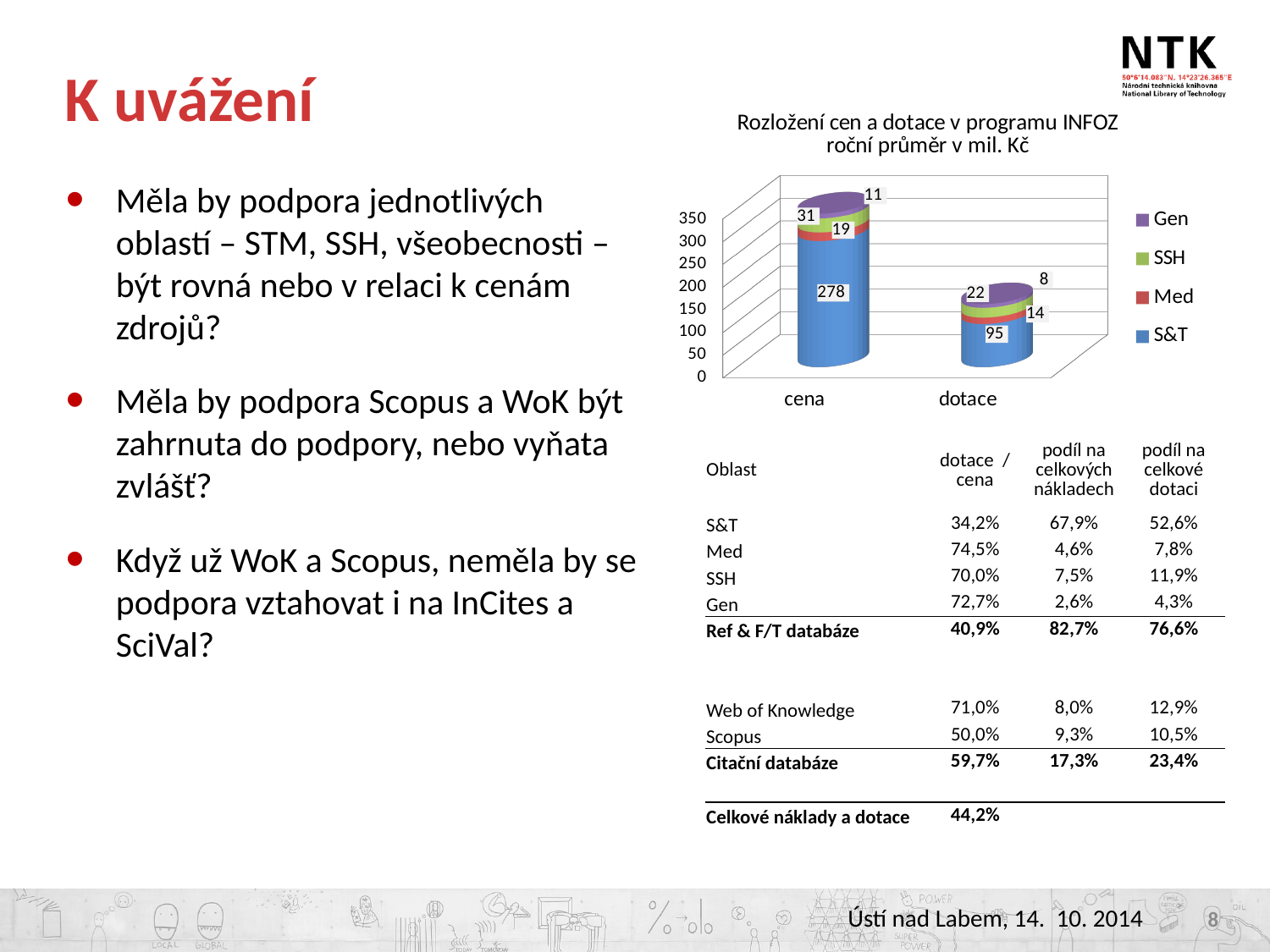
Which is larger, the SSH value for cena or the SSH value for dotace? cena What type of chart is shown on the slide? stacked bar chart What is the total of the stacked bar for cena? 339 How many series does the legend list? 4 Which series has the highest value for cena? S&T What is the value of Med for dotace? 14 What is the value of SSH for cena? 31 What is the value of S&T for dotace? 95 Which series has the lowest value for dotace? Gen What is the difference between the S&T values for cena and dotace? 183 What is the value of Gen for dotace? 8 What is the value of S&T for cena? 278